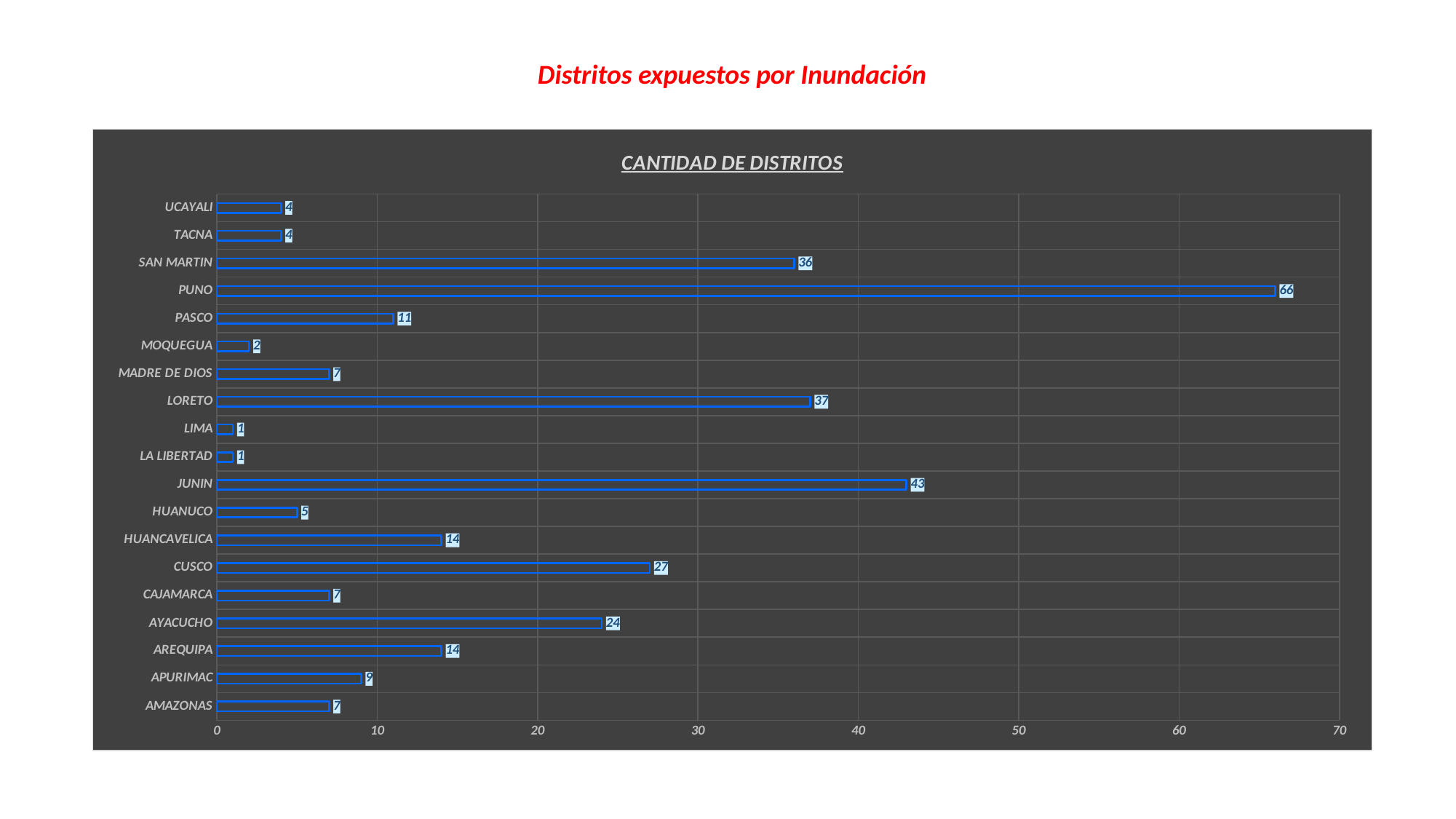
What is the value for HUANCAVELICA? 14 What is the difference between the values for PUNO and JUNIN? 23 How many categories are shown in the chart? 19 What is the value for PUNO? 66 What is the value for LORETO? 37 What is the difference between the values for CUSCO and AYACUCHO? 3 What kind of chart is shown on the slide? bar chart Which category has the highest value? PUNO What is the title of the chart? CANTIDAD DE DISTRITOS Is the value for PUNO greater or less than 60? greater What is the value for MOQUEGUA? 2 Which is larger, the value for JUNIN or the value for CUSCO? JUNIN